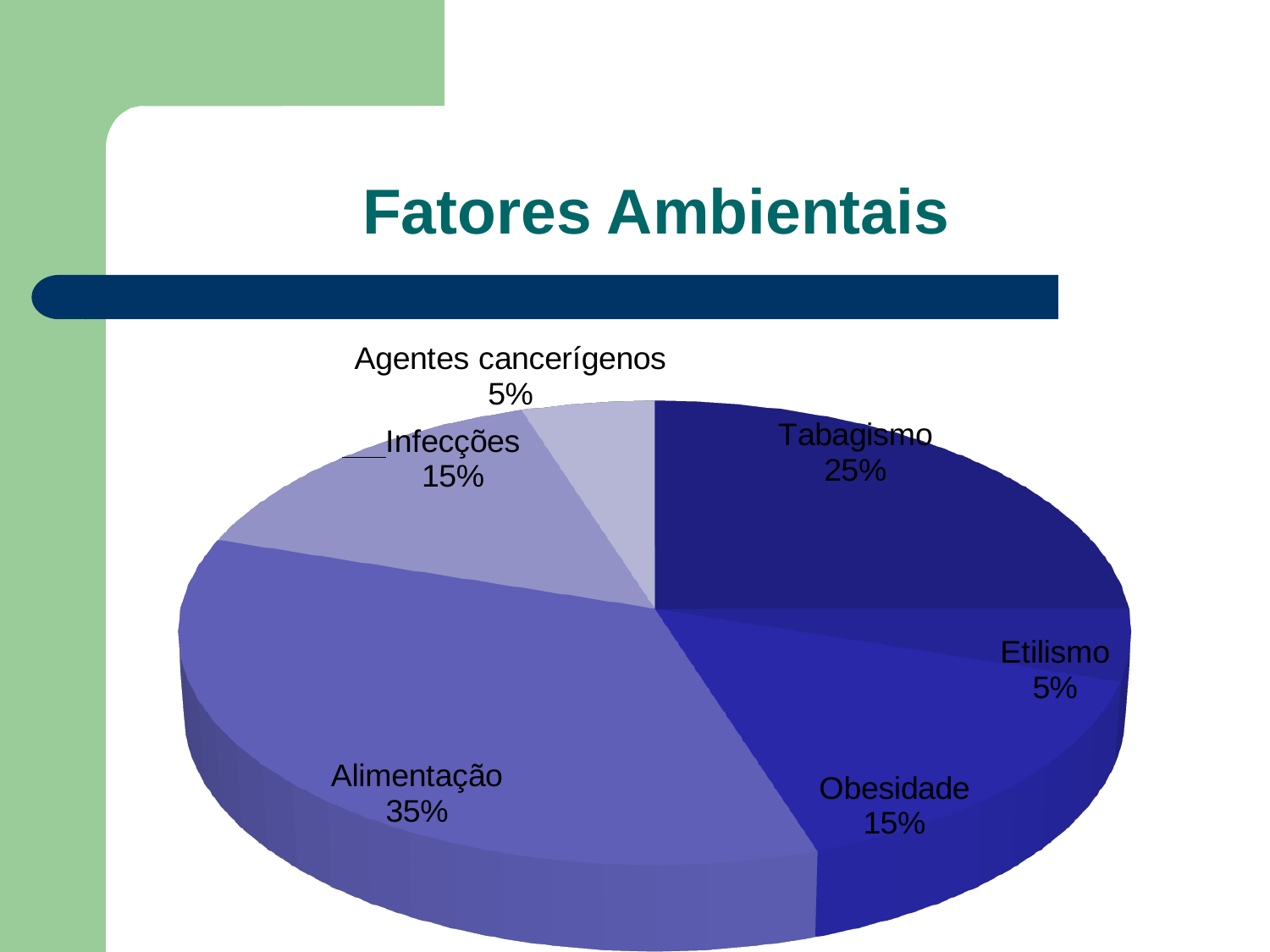
What kind of chart is shown on the slide? pie chart What percentage does the Infecções slice represent? 15% What percentage does the Etilismo slice represent? 5% How many slices does the pie chart have? 6 What percentage does the Alimentação slice represent? 35% What is the title of the chart? Fatores Ambientais Which is larger, the Tabagismo slice or the Obesidade slice? Tabagismo What percentage does the Tabagismo slice represent? 25% Which slice of the pie is the largest? Alimentação By how many percentage points is the Alimentação slice larger than the Tabagismo slice? 10 percentage points What percentage does the Obesidade slice represent? 15% What percentage does the Agentes cancerígenos slice represent? 5%